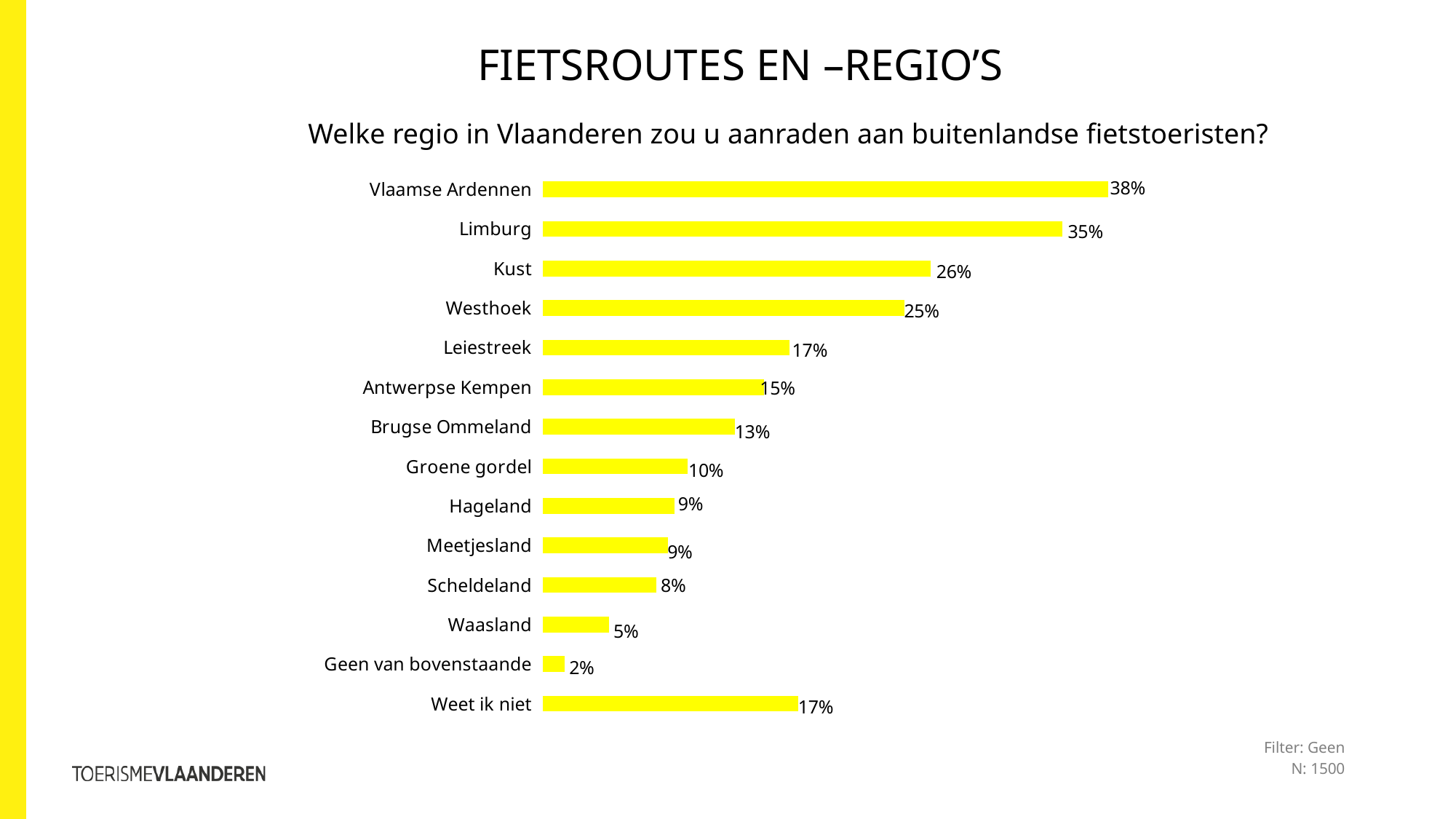
What is the value for Westhoek? 25% What kind of chart is shown on the slide? Bar chart What is the difference between the values for Vlaamse Ardennen and Limburg? 3% What is the difference between the values for Kust and Waasland? 21% Which category has the lowest value? Geen van bovenstaande Which region has the highest value? Vlaamse Ardennen What is the value for Vlaamse Ardennen? 38% What colour are the bars in the chart? Yellow What is the value for Weet ik niet? 17% What is the value for Brugse Ommeland? 13% How many categories are shown in the chart? 14 Which has a larger value, Leiestreek or Antwerpse Kempen? Leiestreek